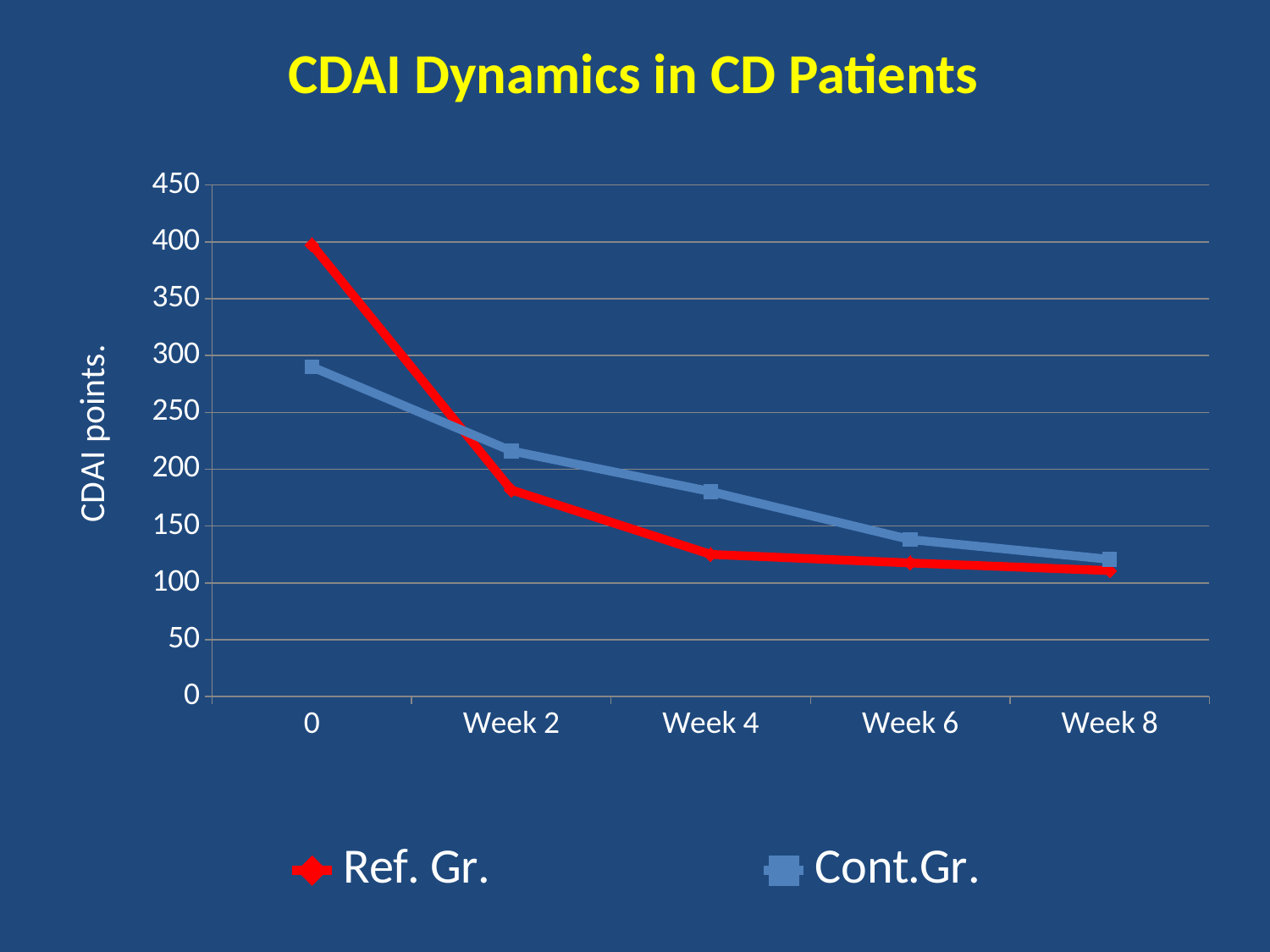
How many series does the legend list? 2 How many time points are plotted along the x axis? 5 What kind of chart is shown on the slide? line chart At time point 0, which series has the larger value, Ref. Gr. or Cont.Gr.? Ref. Gr. What is the label on the vertical axis? CDAI points. Is the value for Ref. Gr. at Week 2 greater or less than 200? less Do the values for Cont.Gr. rise or fall from 0 to Week 8? fall At which time point is the value for Ref. Gr. highest? 0 At which time point is the value for Cont.Gr. lowest? Week 8 What is the title of the chart? CDAI Dynamics in CD Patients Do the values for Ref. Gr. rise or fall from 0 to Week 8? fall At Week 4, which series has the larger value, Ref. Gr. or Cont.Gr.? Cont.Gr.